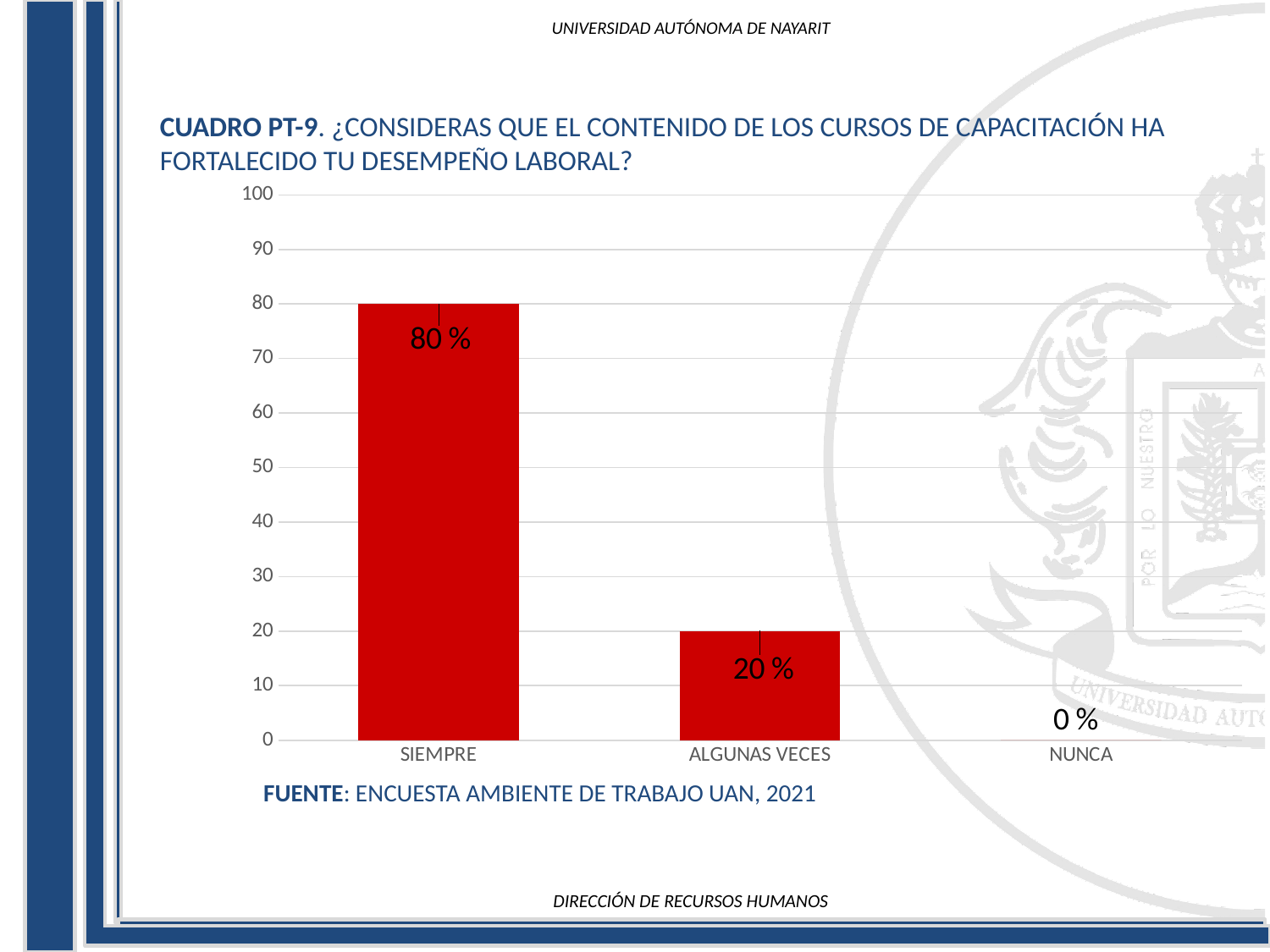
What is the value for SIEMPRE? 80 % Which category has the lowest value? NUNCA What source is cited below the chart? ENCUESTA AMBIENTE DE TRABAJO UAN, 2021 What is the value for NUNCA? 0 % Is the value for SIEMPRE greater or less than 50? greater How many categories are shown on the x axis? 3 Do the values rise or fall from left to right along the x axis? fall Which is larger, the value for ALGUNAS VECES or the value for NUNCA? ALGUNAS VECES What is the value for ALGUNAS VECES? 20 % What is the difference between the values for SIEMPRE and ALGUNAS VECES? 60 % What kind of chart is shown on the slide? bar chart Which category has the highest value? SIEMPRE